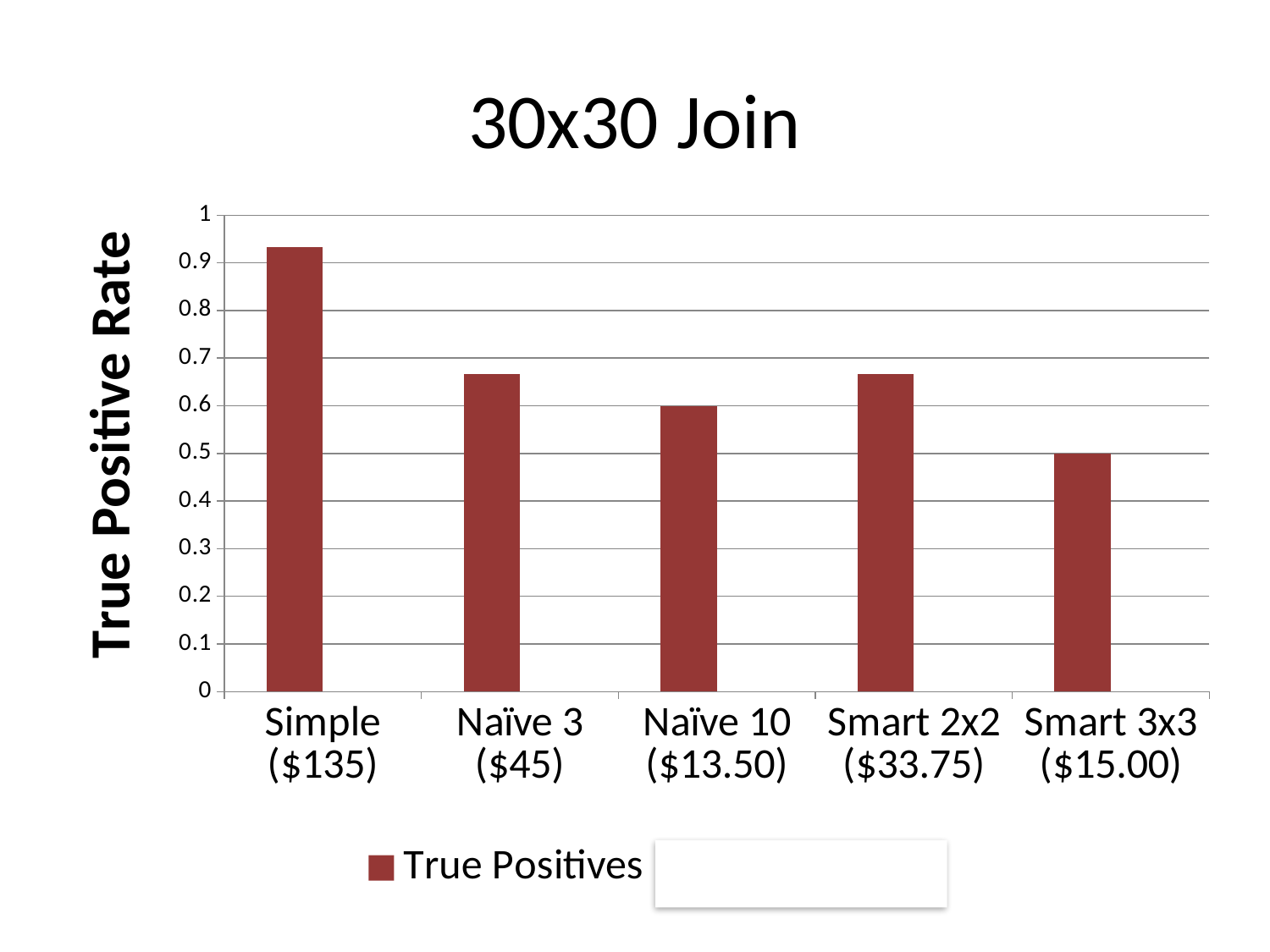
Which category has the highest true positive rate? Simple ($135) What is the true positive rate for Naïve 10 ($13.50)? 0.6 Which category has the lowest true positive rate? Smart 3x3 ($15.00) What is the title of the chart? 30x30 Join What is the label on the y axis? True Positive Rate Which has a higher true positive rate, Simple ($135) or Smart 2x2 ($33.75)? Simple ($135) Is the true positive rate for Naïve 3 ($45) greater or less than 0.6? greater How many categories are plotted along the x axis? 5 Is the true positive rate for Simple ($135) greater or less than 0.9? greater What kind of chart is shown on the slide? bar chart What is the true positive rate for Smart 3x3 ($15.00)? 0.5